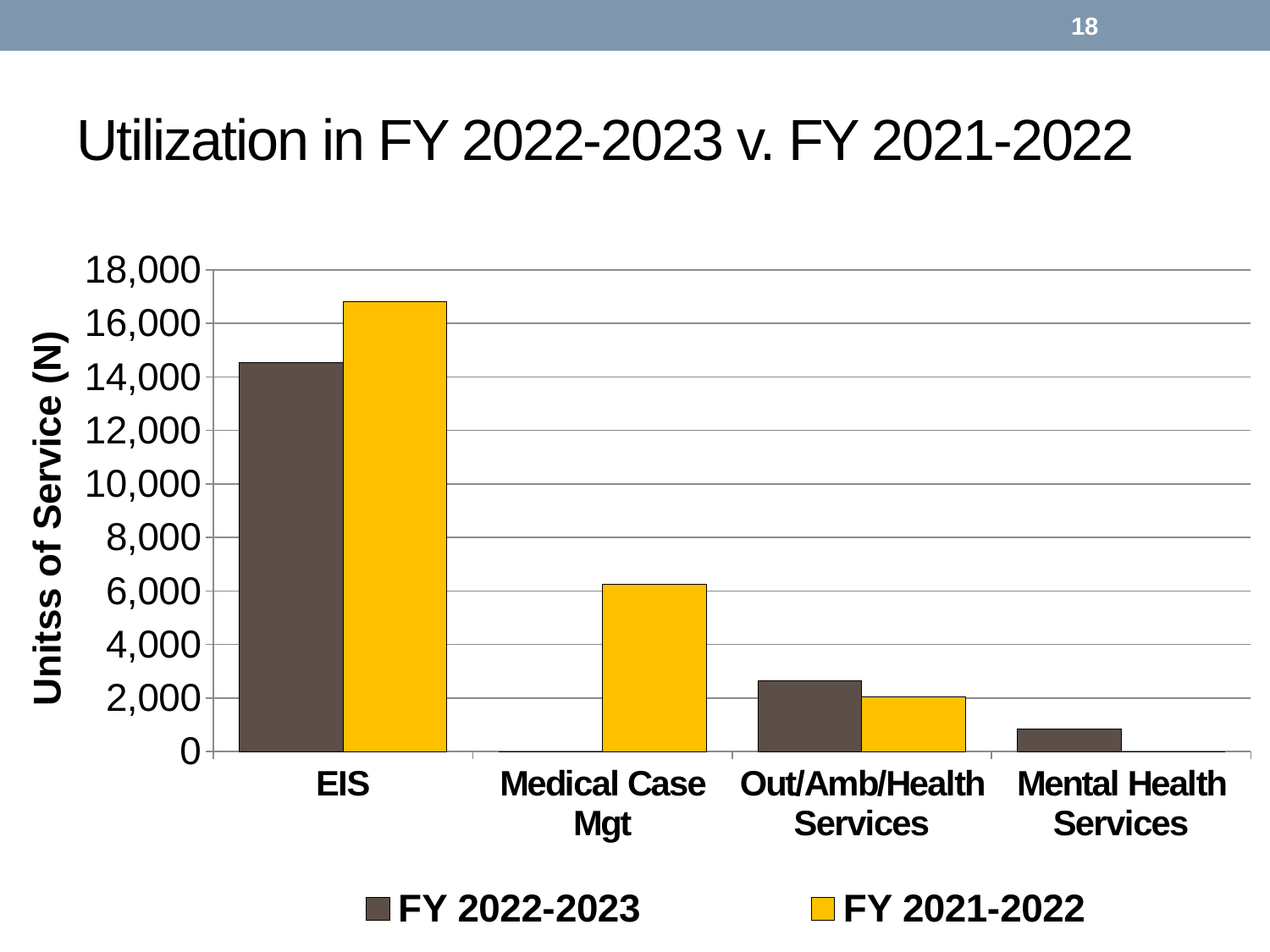
How many categories are shown on the x axis? 4 Which category has the highest FY 2021-2022 value? EIS Is the FY 2021-2022 value for Medical Case Mgt greater or less than 6,000? greater For Out/Amb/Health Services, which series has the larger value, FY 2022-2023 or FY 2021-2022? FY 2022-2023 Is the FY 2022-2023 value for Out/Amb/Health Services greater or less than 2,000? greater Is the FY 2021-2022 value for EIS greater or less than 16,000? greater How many series does the legend list? 2 For EIS, which series has the larger value, FY 2022-2023 or FY 2021-2022? FY 2021-2022 Which category has the highest FY 2022-2023 value? EIS What kind of chart is shown on the slide? bar chart What is the label on the vertical axis of the chart? Unitss of Service (N)